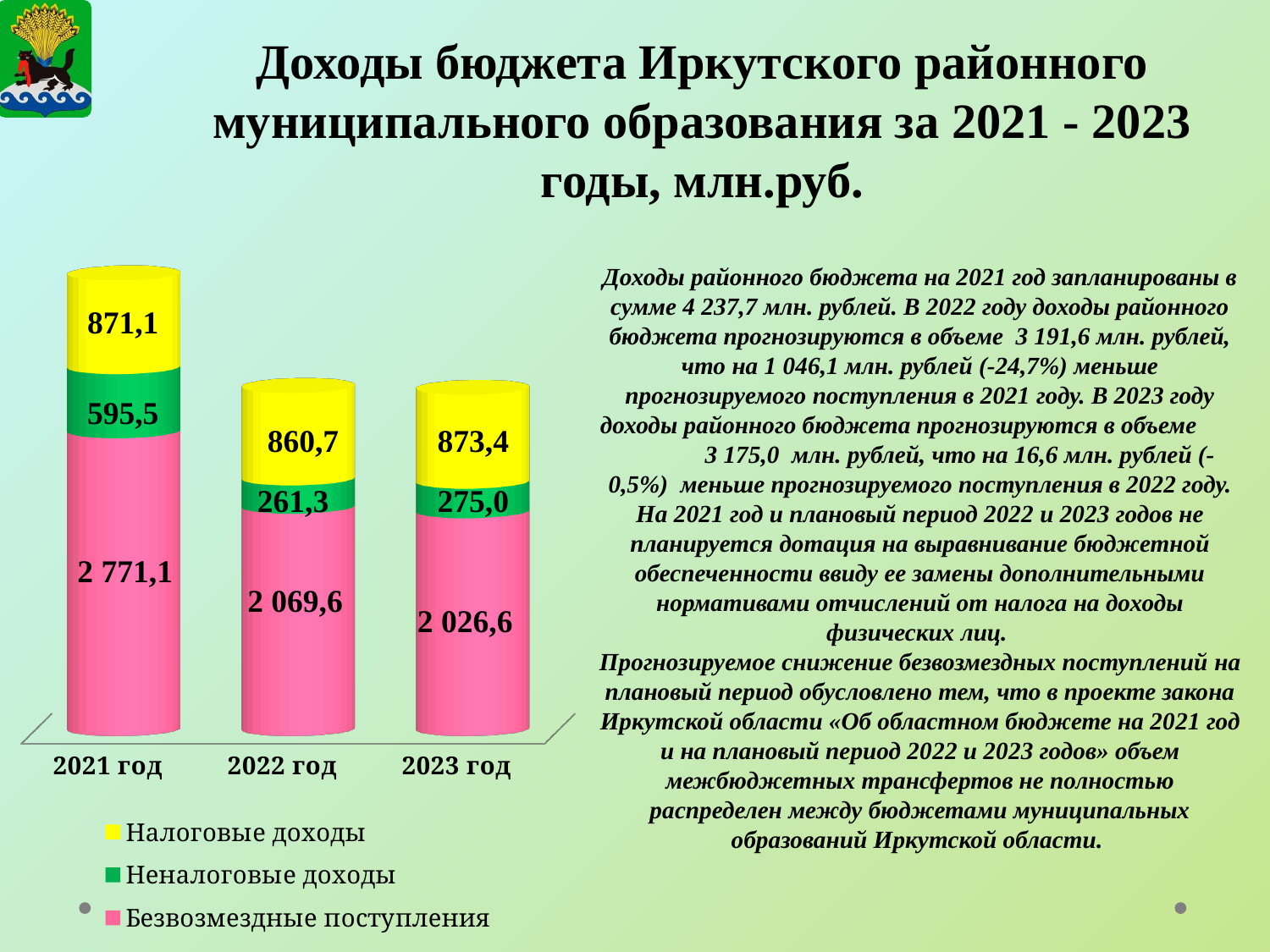
Which is larger: Налоговые доходы in 2023 год or in 2022 год? 2023 год What is the difference between Безвозмездные поступления in 2021 год and 2022 год? 701,5 Which year has the highest value for Неналоговые доходы? 2021 год What is the value of Налоговые доходы for 2021 год? 871,1 What is the total of the stacked bar for 2023 год? 3 175,0 What kind of chart is shown on the slide? Stacked bar chart What is the value of Безвозмездные поступления for 2023 год? 2 026,6 How many series does the legend list? 3 How many years are shown on the x axis? 3 What is the total of the stacked bar for 2021 год? 4 237,7 Which year has the lowest value for Безвозмездные поступления? 2023 год What is the value of Неналоговые доходы for 2022 год? 261,3